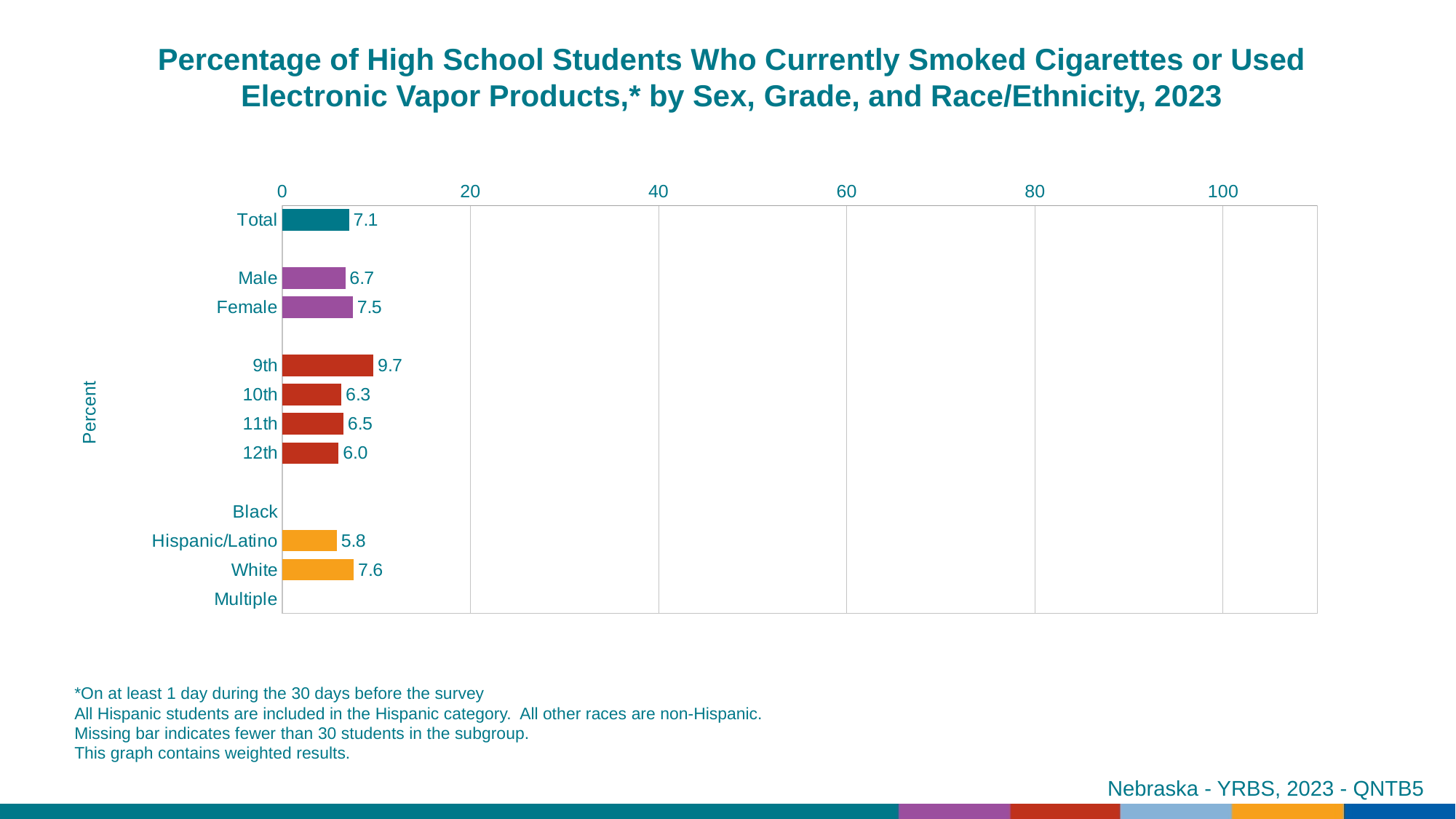
What is the difference between the 9th grade and 12th grade values? 3.7 Which is larger, the value for White or the value for Hispanic/Latino? White Is the value for 9th grade greater or less than 20? less Which category with a plotted bar has the lowest value? Hispanic/Latino Which grade has the highest value? 9th What is the difference between the Female and Male values? 0.8 What kind of chart is shown? bar chart What is the value for Hispanic/Latino? 5.8 How many categories have no bar plotted? 2 What is the value for 9th grade? 9.7 What is the label on the vertical axis? Percent What is the value for Total? 7.1